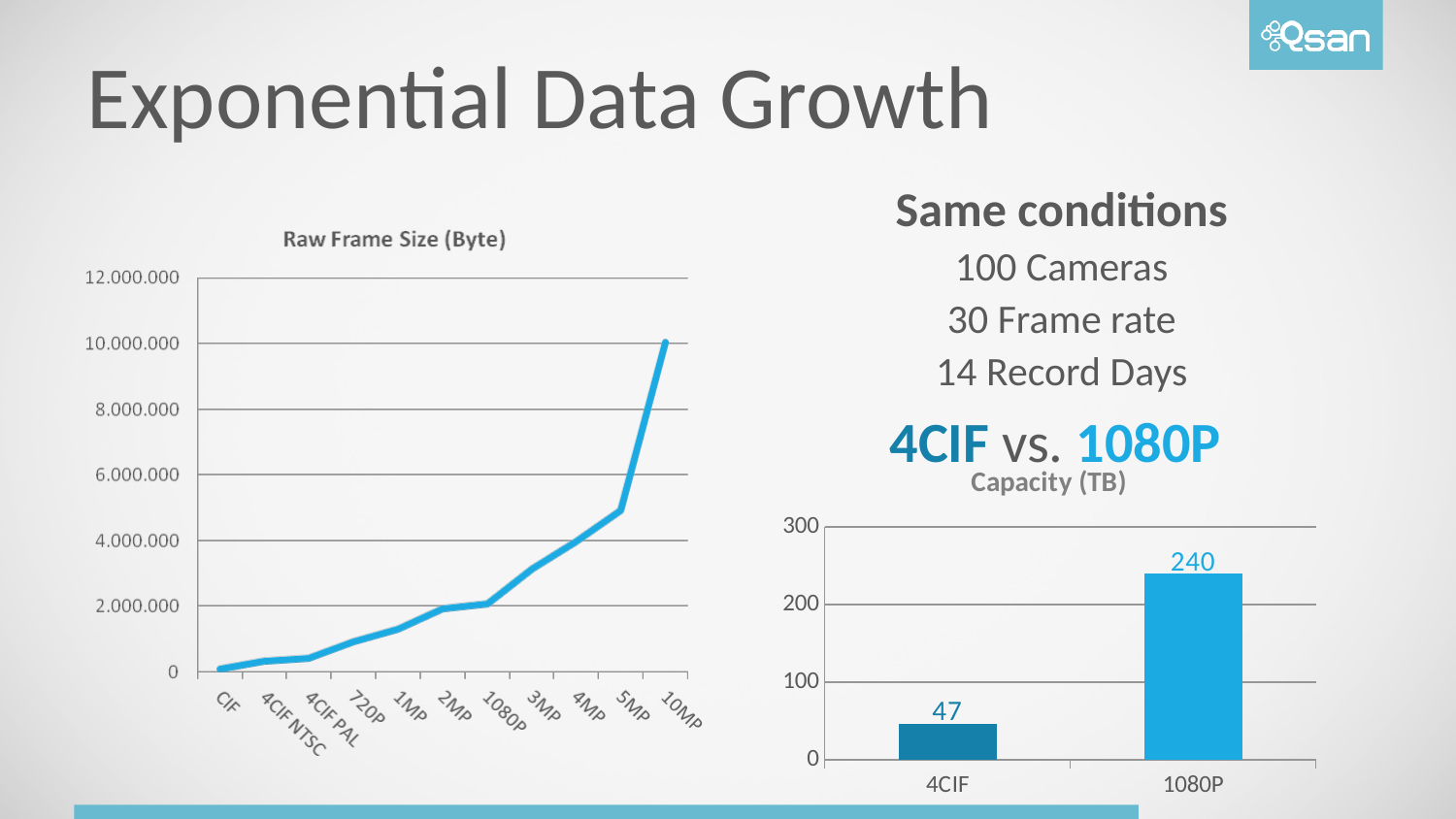
What kind of chart is the Capacity (TB) chart? bar chart In the Capacity (TB) bar chart, what is the value for 1080P? 240 In the Capacity (TB) bar chart, what is the value for 4CIF? 47 In the Raw Frame Size (Byte) chart, is the value for 5MP greater or less than 6.000.000? less In the Capacity (TB) bar chart, how many categories are shown? 2 In the Capacity (TB) bar chart, what is the difference between the 1080P and 4CIF values? 193 In the Raw Frame Size (Byte) chart, how many categories are on the x axis? 11 In the Capacity (TB) bar chart, which category has the higher value, 4CIF or 1080P? 1080P In the Raw Frame Size (Byte) chart, do the values generally rise or fall from CIF to 10MP? rise What kind of chart is the Raw Frame Size (Byte) chart? line chart In the Raw Frame Size (Byte) chart, which category has the lowest value? CIF In the Raw Frame Size (Byte) chart, which category has the highest value? 10MP